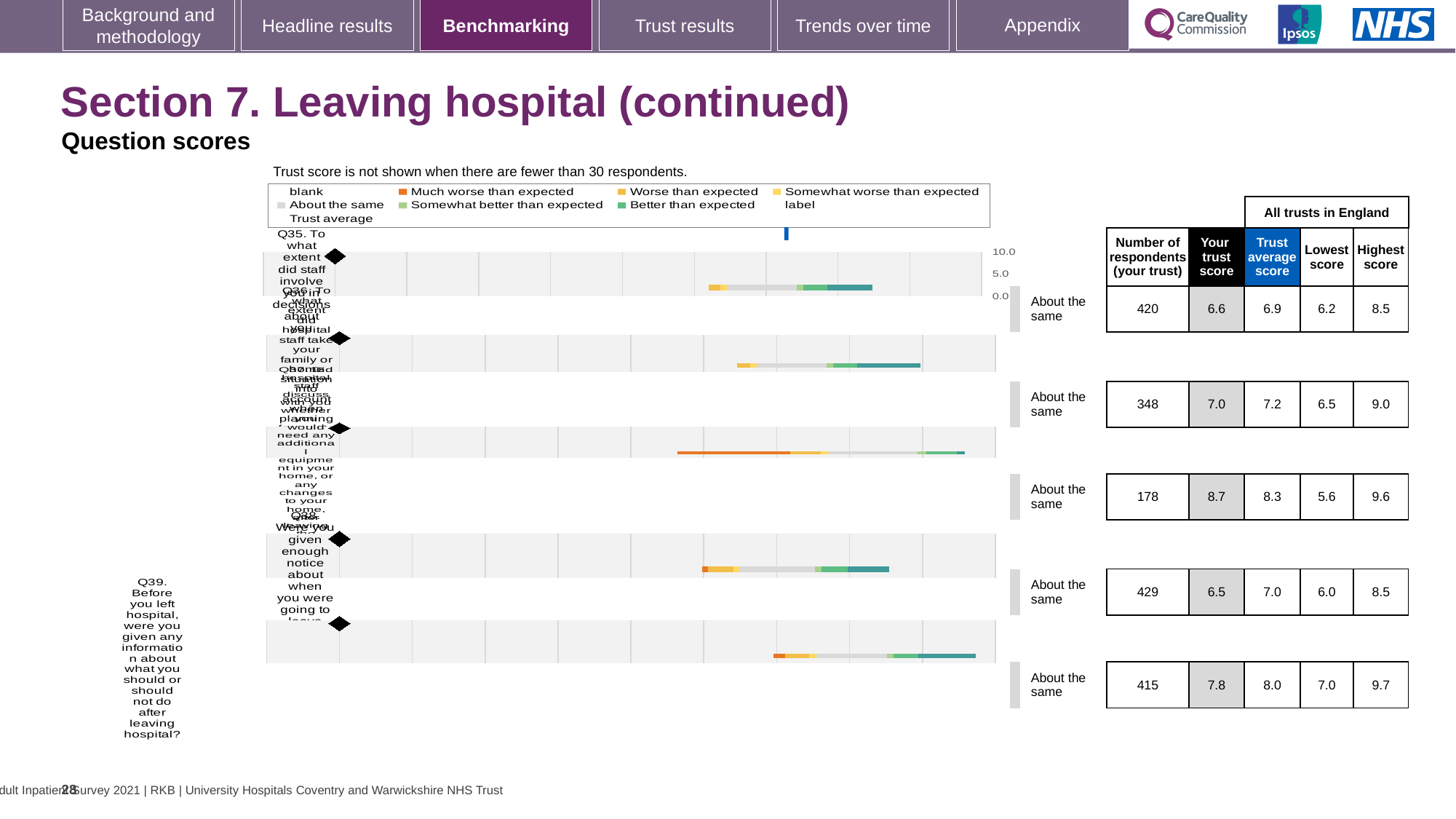
What is the 'Your trust score' for Q38, about being given enough notice about when you were going to leave hospital? 6.5 What colour in the legend represents 'Much worse than expected'? Orange What is the highest 'Your trust score' value shown in the table? 8.7 What benchmark category is shown for every question on this slide? About the same What is the number of respondents (your trust) for Q39, about being given information on what you should or should not do after leaving hospital? 415 How many questions (rows) are shown in the benchmarking chart and table? 5 What is the highest score across all trusts in England for Q36, about staff taking your family or home situation into account? 9.0 What kind of chart is used to show the question scores on this slide? bar chart What is the 'Your trust score' for Q35, about staff involving you in decisions about leaving hospital? 6.6 For Q35, which is larger: your trust score or the trust average score? Trust average score For Q39, what is the difference between the trust average score (8.0) and your trust score (7.8)? 0.2 What is the lowest number of respondents shown in the table? 178